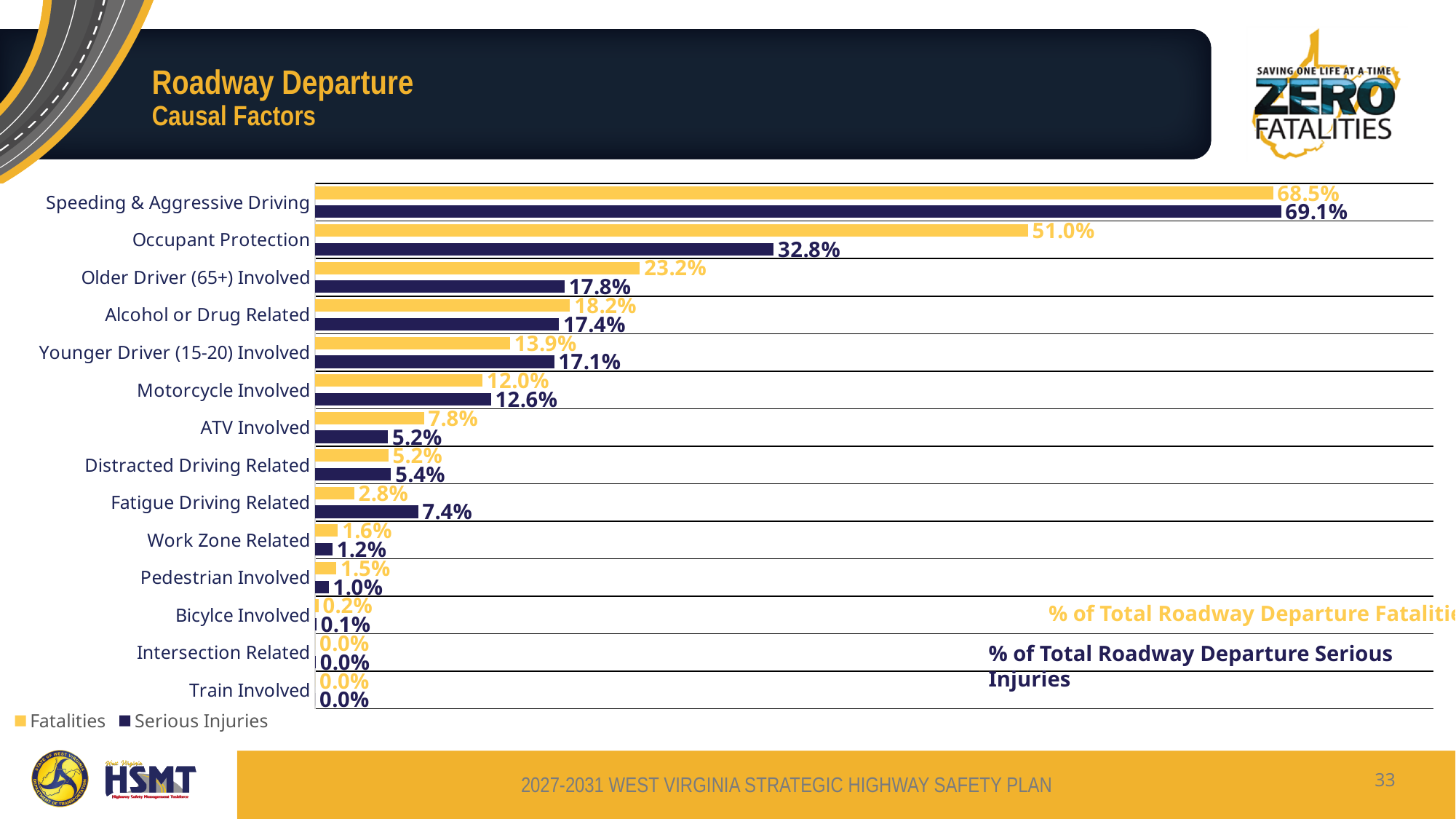
For Fatigue Driving Related, which is larger: the Fatalities value or the Serious Injuries value? Serious Injuries What kind of chart is shown on the slide? Bar chart What is the Fatalities value for Fatigue Driving Related? 2.8% What is the Serious Injuries value for Younger Driver (15-20) Involved? 17.1% What is the difference between the Fatalities and Serious Injuries values for Occupant Protection? 18.2% How many causal factor categories are plotted on the chart? 14 How many series does the legend list? 2 Which category has the highest Serious Injuries value? Speeding & Aggressive Driving Which colour represents the Fatalities series in the chart? Yellow What is the difference between the Fatalities values for Older Driver (65+) Involved and Alcohol or Drug Related? 5.0% What is the Fatalities value for Occupant Protection? 51.0% What is the Serious Injuries value for ATV Involved? 5.2%